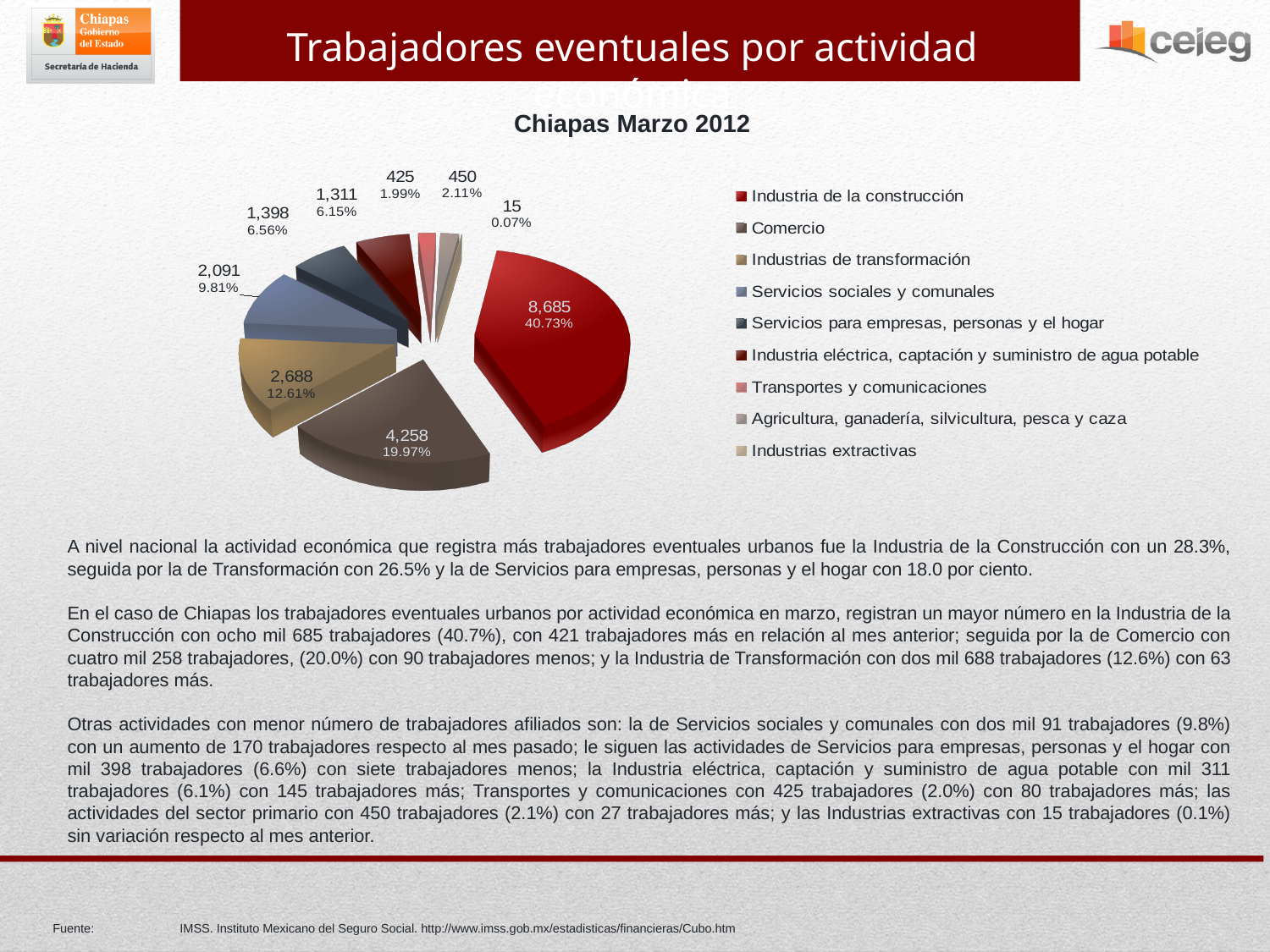
What is the value shown for Industrias de transformación? 2,688 What type of chart is shown on the slide? pie chart What is the subtitle shown above the pie chart? Chiapas Marzo 2012 Which category has the largest slice of the pie? Industria de la construcción Which category has the smallest slice of the pie? Industrias extractivas Which is larger, the value for Transportes y comunicaciones or the value for Agricultura, ganadería, silvicultura, pesca y caza? Agricultura, ganadería, silvicultura, pesca y caza How many categories does the legend of the pie chart list? 9 What percentage share is shown for Servicios sociales y comunales? 9.81% What is the value shown for Industria de la construcción? 8,685 What is the difference between the values for Industria de la construcción and Comercio? 4,427 What percentage share does the Comercio slice have? 19.97% What is the value shown for Industria eléctrica, captación y suministro de agua potable? 1,311